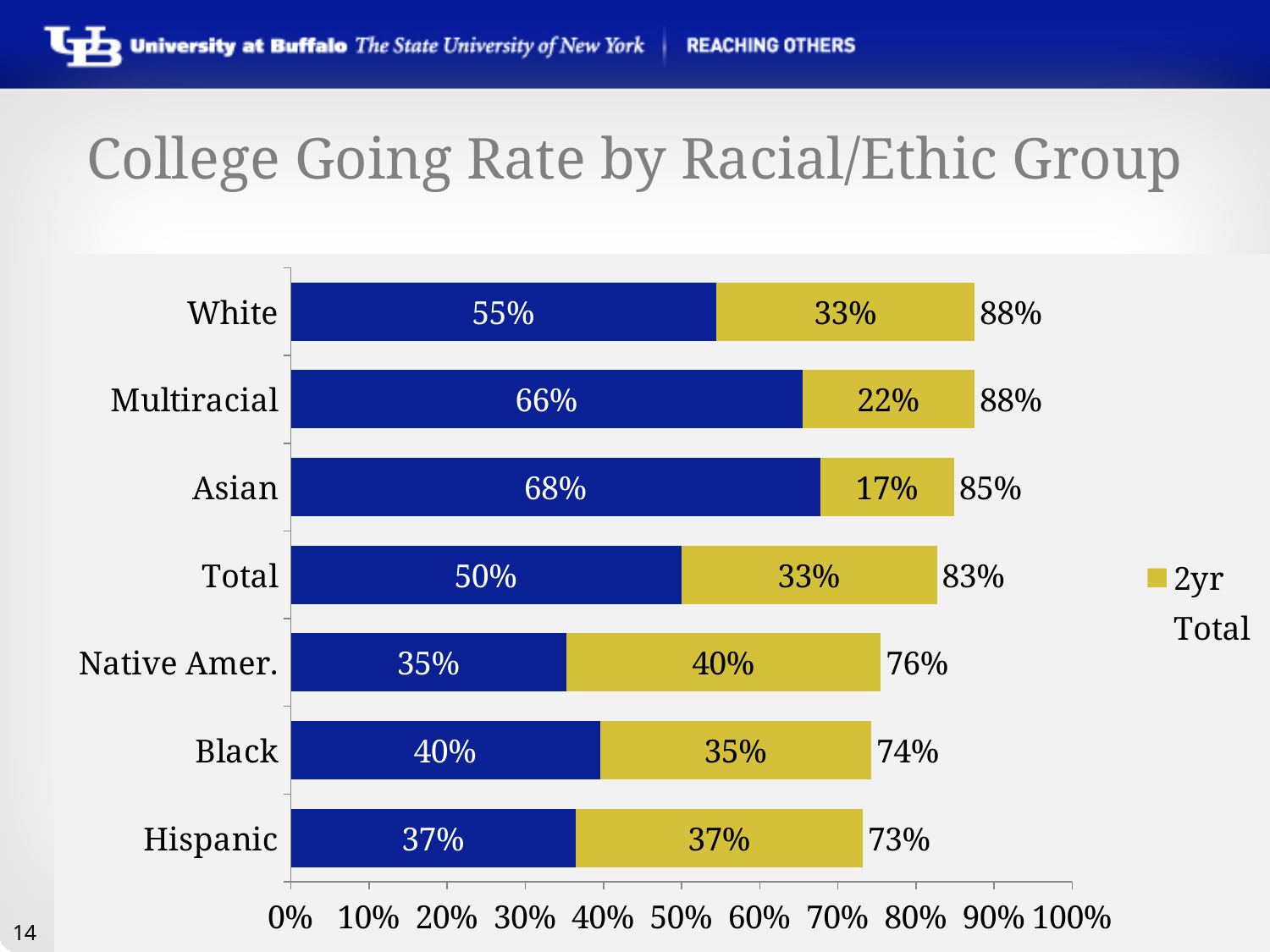
What is the value of the blue segment for Multiracial? 66% What is the title of the chart? College Going Rate by Racial/Ethic Group Which has the larger 2yr value, White or Multiracial? White How many groups are shown on the chart? 7 What is the 2yr value for Native Amer.? 40% What total college going rate is shown for Asian? 85% Which group has the lowest total college going rate? Hispanic What is the 2yr value for Black? 35% Which group has the highest 2yr value? Native Amer. Which group has the lowest 2yr value? Asian What is the difference between the total rate for Asian and the total rate for Hispanic? 12% What kind of chart is shown on the slide? Stacked bar chart